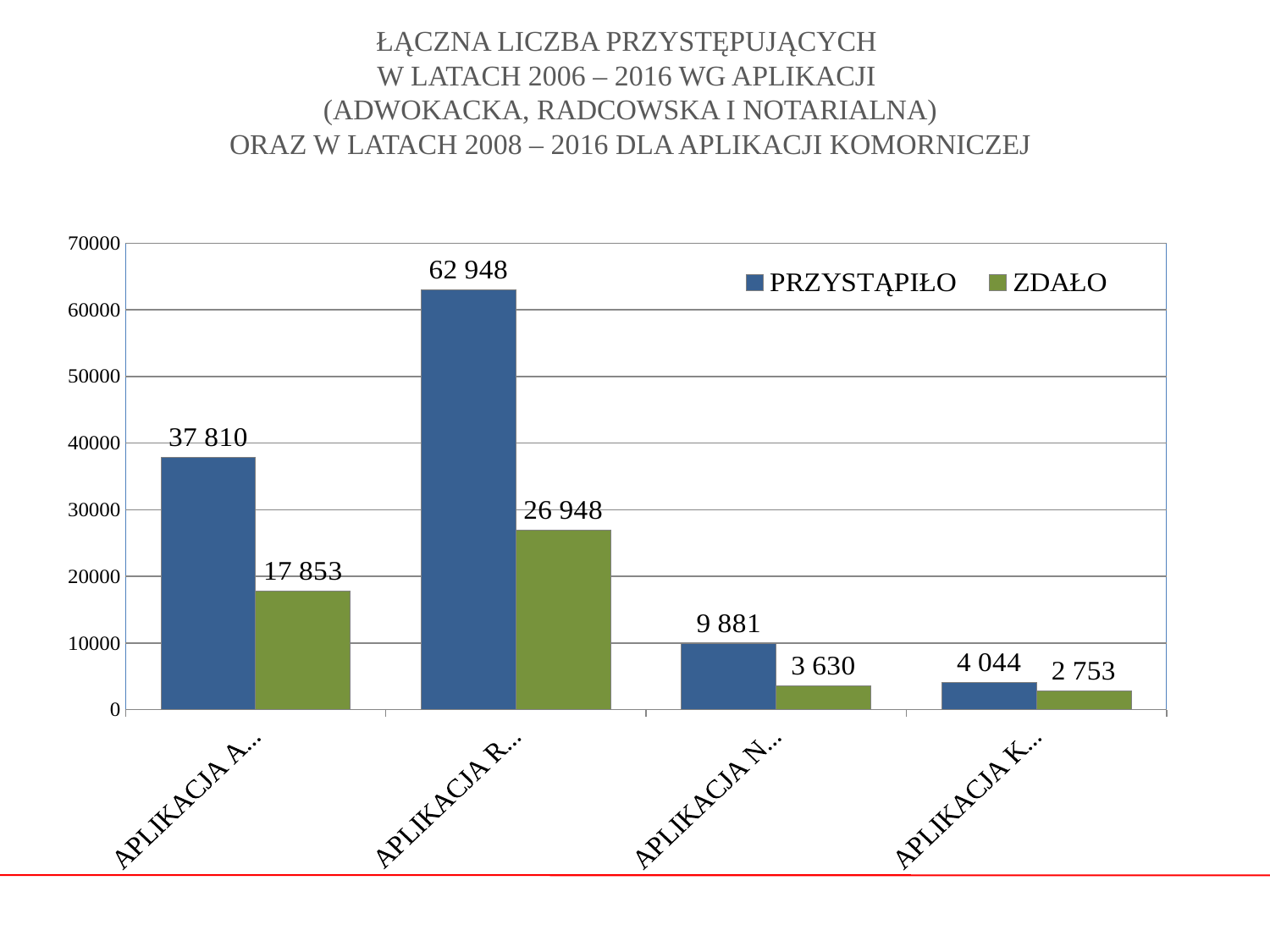
How many series does the legend list? 2 What is the PRZYSTĄPIŁO value for the fourth category (APLIKACJA K...)? 4 044 What is the ZDAŁO value for the third category (APLIKACJA N...)? 3 630 How many categories are shown on the x axis? 4 What is the ZDAŁO value for the second category (APLIKACJA R...)? 26 948 What is the PRZYSTĄPIŁO value for the first category (APLIKACJA A...)? 37 810 Which series is shown in green in the legend? ZDAŁO What is the difference between PRZYSTĄPIŁO and ZDAŁO for the second category (APLIKACJA R...)? 36 000 Which is larger: the ZDAŁO value for APLIKACJA A... or the PRZYSTĄPIŁO value for APLIKACJA N...? ZDAŁO value for APLIKACJA A... What type of chart is shown on the slide? bar chart Which category has the lowest ZDAŁO value? APLIKACJA K... Which category has the highest PRZYSTĄPIŁO value? APLIKACJA R...